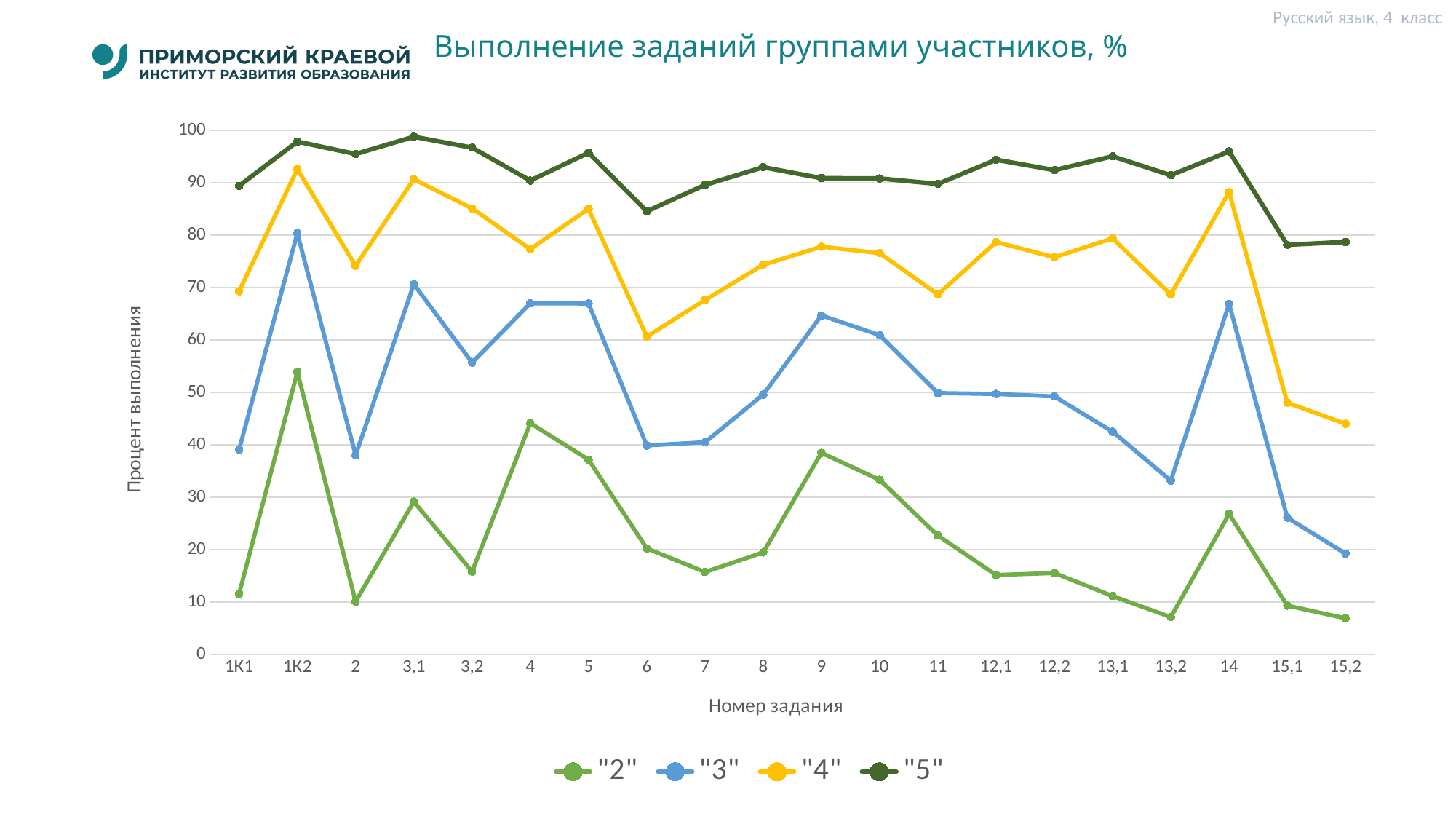
At which task does series "3" reach its lowest value? 15,2 Is the value for series "2" at task 1К2 greater or less than 50? greater What is the title of the vertical axis? Процент выполнения For series "2", which task has the larger value: 1К2 or 4? 1К2 Does series "3" rise or fall from task 14 to task 15,2? fall Is the value for series "5" at task 6 greater or less than 90? less What kind of chart is shown on the slide? line chart How many task numbers (categories) are shown along the x axis? 20 Is the value for series "4" at task 15,2 greater or less than 50? less How many series does the legend list? 4 At which task does series "3" reach its highest value? 1К2